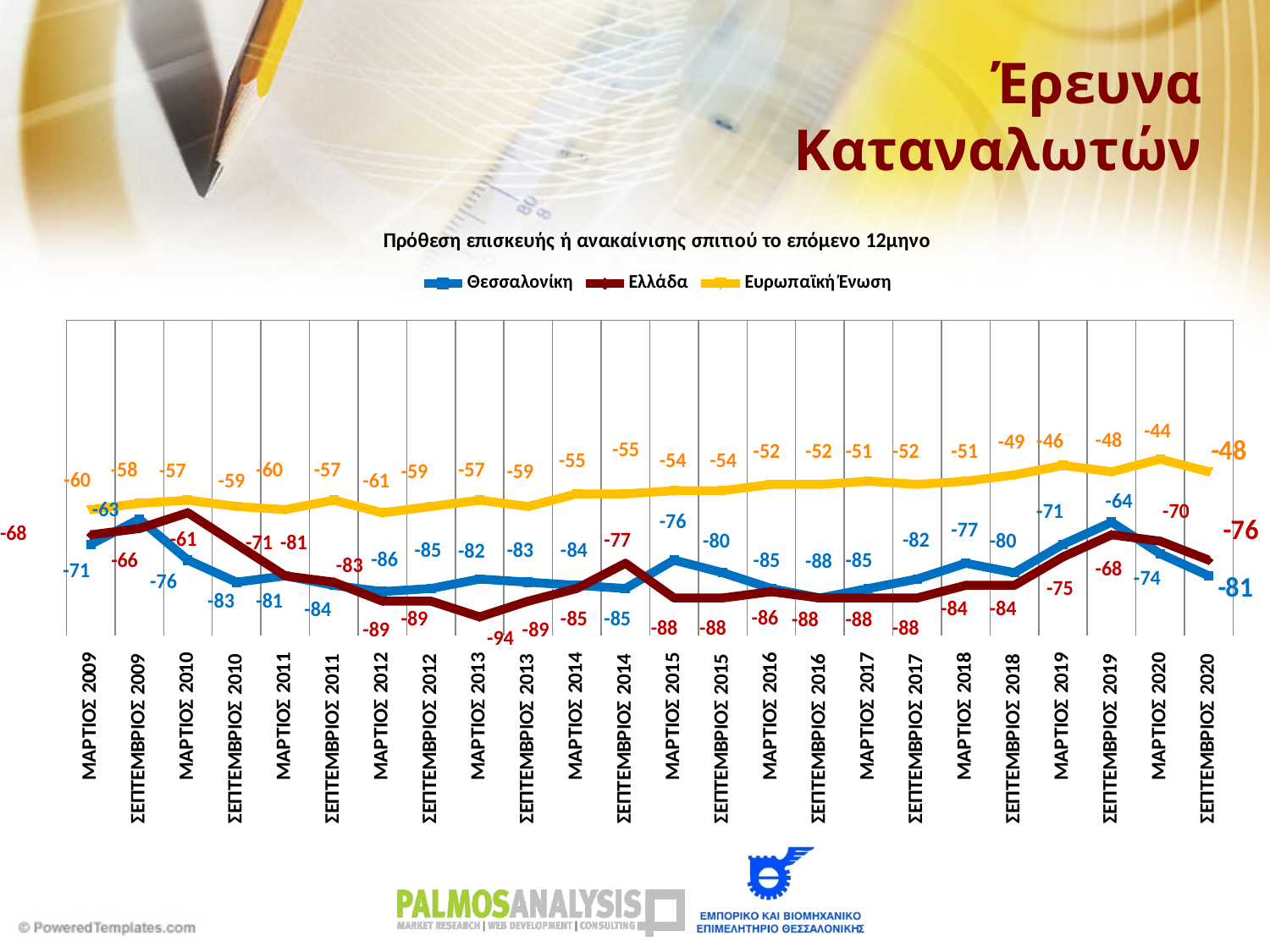
What kind of chart is shown on the slide? line chart In which period does Ευρωπαϊκή Ένωση reach its highest value? ΜΑΡΤΙΟΣ 2020 What is the title of the chart? Πρόθεση επισκευής ή ανακαίνισης σπιτιού το επόμενο 12μηνο In which period does Ελλάδα reach its lowest value? ΜΑΡΤΙΟΣ 2013 What is the value for Ευρωπαϊκή Ένωση in ΣΕΠΤΕΜΒΡΙΟΣ 2020? -48 In ΣΕΠΤΕΜΒΡΙΟΣ 2020, which series has the higher value, Ευρωπαϊκή Ένωση or Ελλάδα? Ευρωπαϊκή Ένωση How many series does the legend list? 3 How many time points are plotted along the x axis? 24 What is the difference between the Ελλάδα and Θεσσαλονίκη values in ΣΕΠΤΕΜΒΡΙΟΣ 2020? 5 What is the value for Ελλάδα in ΣΕΠΤΕΜΒΡΙΟΣ 2020? -76 What is the value for Ελλάδα in ΜΑΡΤΙΟΣ 2013? -94 What is the value for Θεσσαλονίκη in ΣΕΠΤΕΜΒΡΙΟΣ 2020? -81